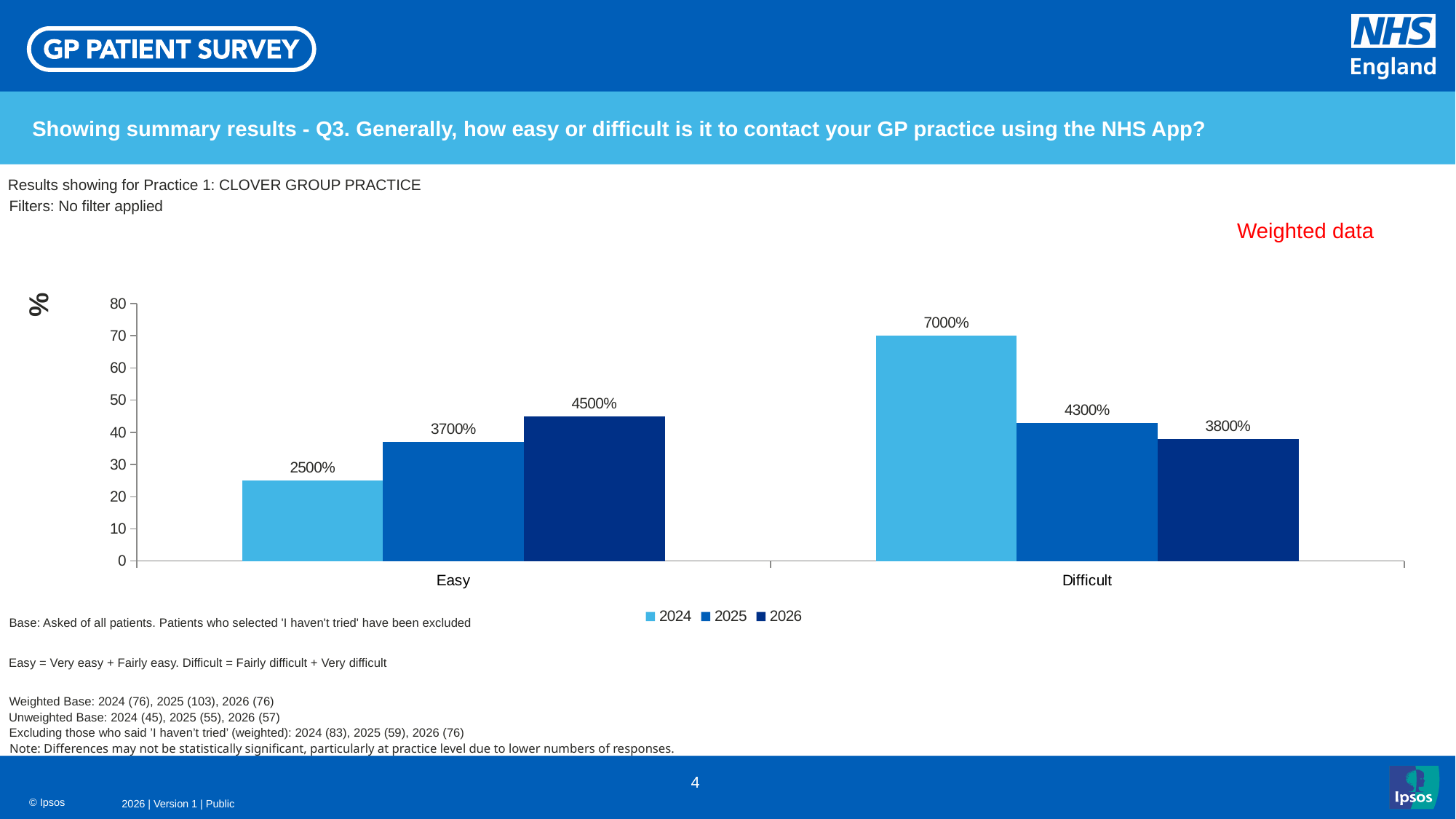
Which is larger: the 2025 value for Easy or the 2025 value for Difficult? Difficult What is the value for 2025 in the Easy category? 3700% Is the 2024 bar for Difficult greater or less than 60 on the axis? greater Do the values for the Difficult category rise or fall from 2024 to 2026? fall What is the value for 2024 in the Easy category? 2500% How many categories are shown on the x axis? 2 What kind of chart is shown on the slide? bar chart What is the difference between the 2026 and 2025 values in the Easy category? 800% Which year has the lowest value in the Easy category? 2024 How many series does the legend list? 3 What is the value for 2026 in the Difficult category? 3800% Which year has the highest value in the Difficult category? 2024